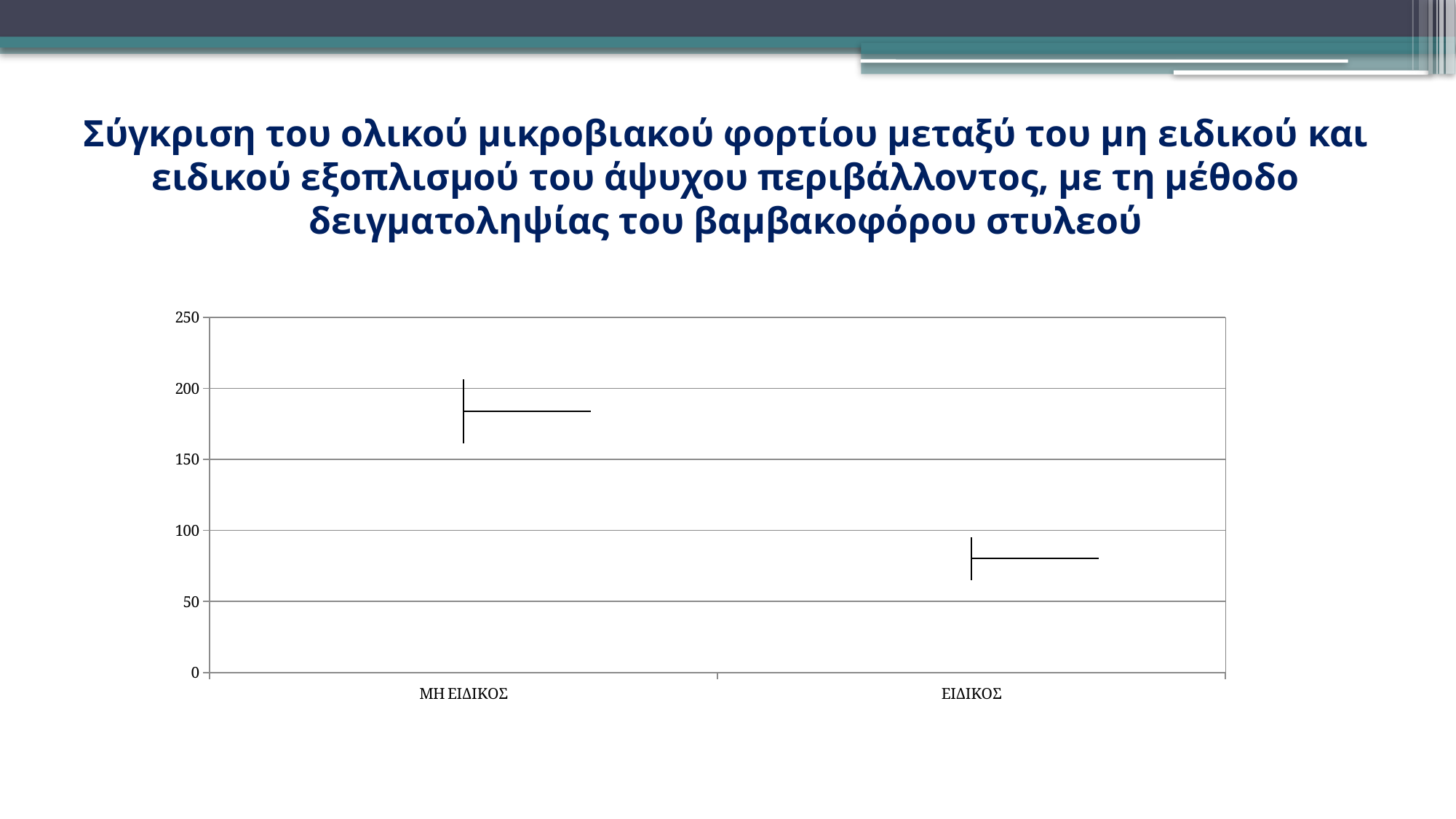
Do the values rise or fall from left to right along the x axis? fall Is the value for ΕΙΔΙΚΟΣ greater or less than 50? greater How many categories are shown on the x axis of the chart? 2 Which category has the higher value in the chart? ΜΗ ΕΙΔΙΚΟΣ Is the value for ΜΗ ΕΙΔΙΚΟΣ greater or less than 150? greater Is the value for ΜΗ ΕΙΔΙΚΟΣ larger or smaller than the value for ΕΙΔΙΚΟΣ? larger Is the value for ΕΙΔΙΚΟΣ greater or less than 100? less What is the label of the first category on the x axis? ΜΗ ΕΙΔΙΚΟΣ What is the highest tick value shown on the y axis of the chart? 250 Which category has the lower value in the chart? ΕΙΔΙΚΟΣ